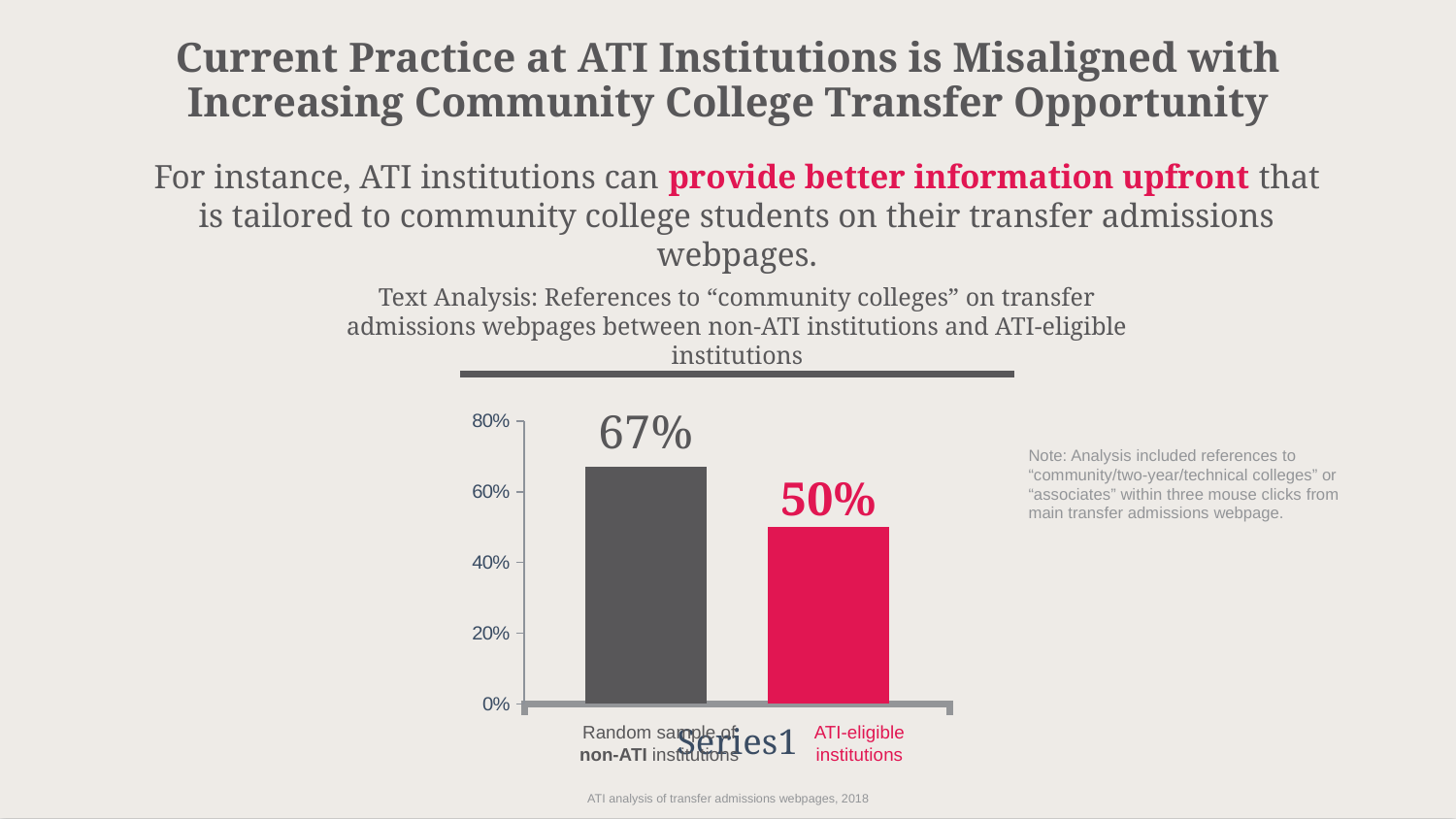
Is the value for ATI-eligible institutions greater or less than 60%? less What colour is the bar for ATI-eligible institutions? Red Which category has the lower value? ATI-eligible institutions Which category has the higher value? Random sample of non-ATI institutions How many bars are shown in the chart? 2 Is the value for the random sample of non-ATI institutions greater or less than 60%? greater What kind of chart is shown on the slide? Bar chart What is the difference between the value for non-ATI institutions and the value for ATI-eligible institutions? 17% What is the value for the random sample of non-ATI institutions? 67% What is the highest value shown on the vertical axis? 80% What is the value for ATI-eligible institutions? 50%